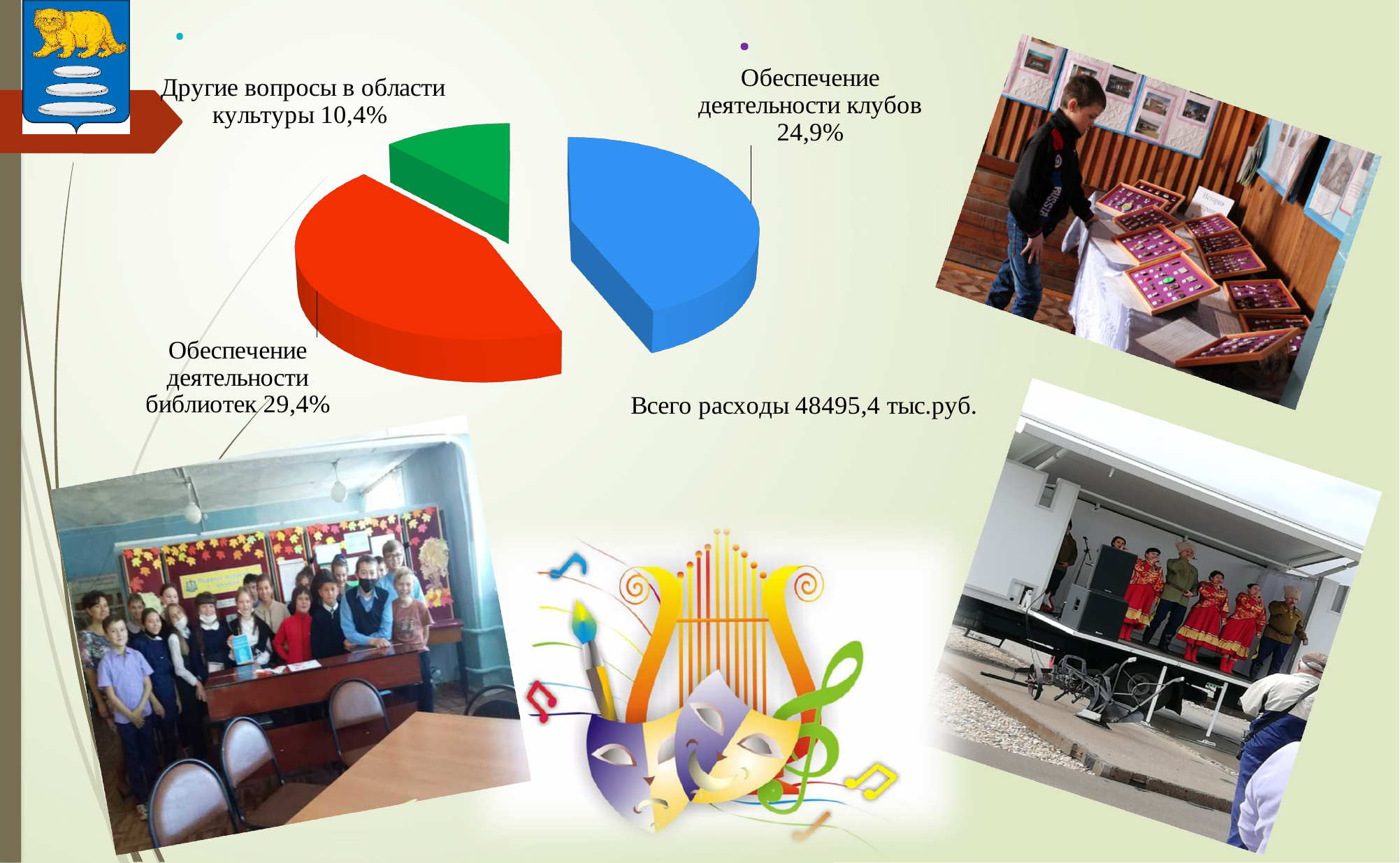
What colour is the slice for "Обеспечение деятельности библиотек"? Red Which category has the smallest slice in the pie chart? Другие вопросы в области культуры Which is larger: the share for "Обеспечение деятельности клубов" or for "Другие вопросы в области культуры"? Обеспечение деятельности клубов What percentage is shown for "Обеспечение деятельности клубов"? 24,9% How many slices does the pie chart have? 3 What share of the pie chart is labelled for "Обеспечение деятельности библиотек"? 29,4% Which category has the largest slice in the pie chart? Обеспечение деятельности библиотек By how many percentage points does "Обеспечение деятельности клубов" exceed "Другие вопросы в области культуры"? 14,5 What percentage is shown for "Другие вопросы в области культуры"? 10,4% What total expenditure is stated next to the pie chart? 48495,4 тыс.руб. What type of chart is shown on the slide? Pie chart By how many percentage points does "Обеспечение деятельности библиотек" exceed "Обеспечение деятельности клубов"? 4,5